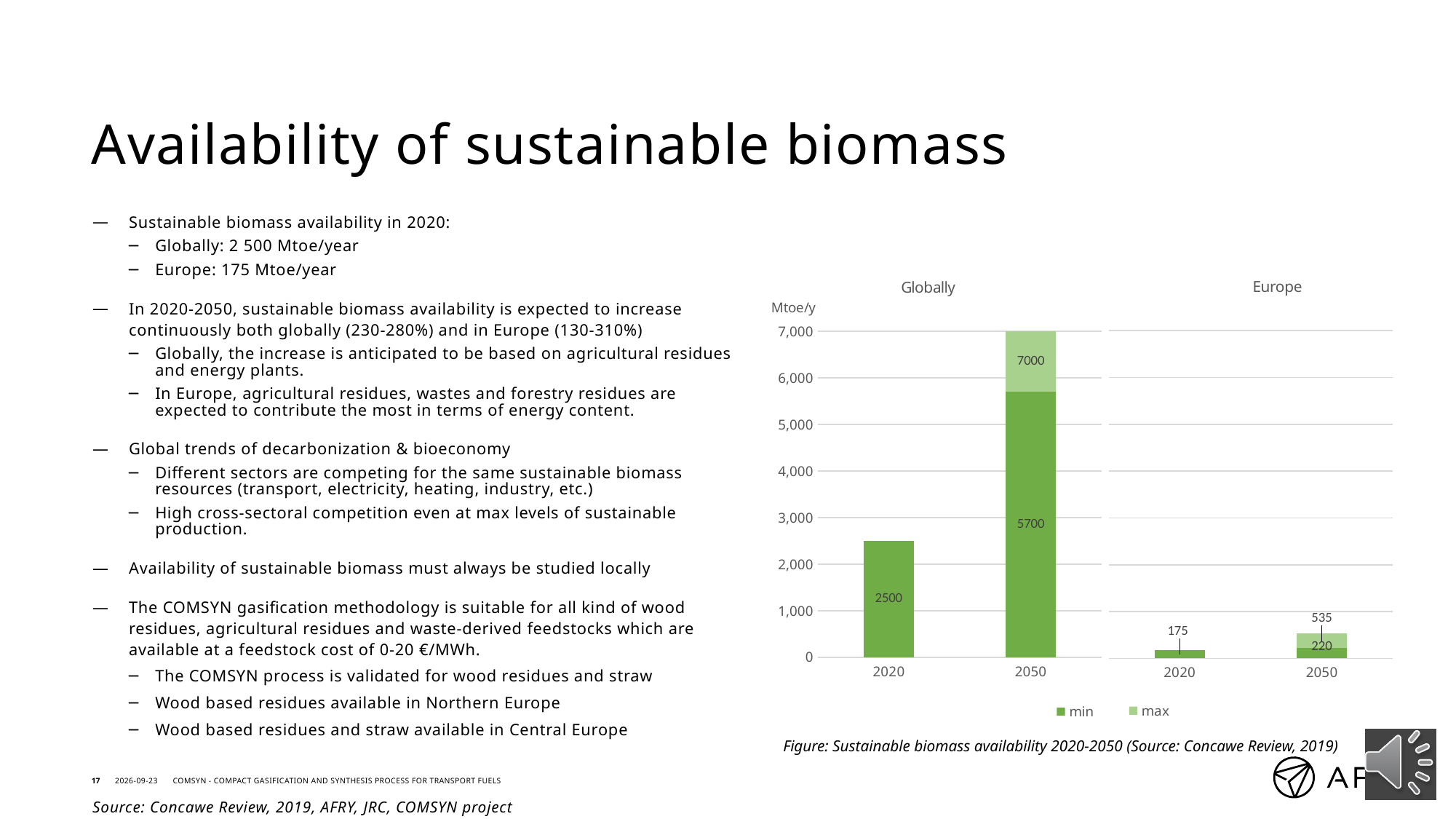
What is the difference between the max and min values for Europe in 2050? 315 What is the max value for Globally in 2050? 7000 Is the Globally min value for 2020 greater or less than 3,000? less Which is larger, the Globally min value for 2020 or the Globally min value for 2050? 2050 What is the max value for Europe in 2050? 535 What is the difference between the Globally min values for 2050 and 2020? 3200 What is the min value for Europe in 2020? 175 What is the min value for Globally in 2050? 5700 What is the min value for Europe in 2050? 220 What kind of chart is shown on the slide? bar chart How many series does the legend list? 2 What is the min value for Globally in 2020? 2500